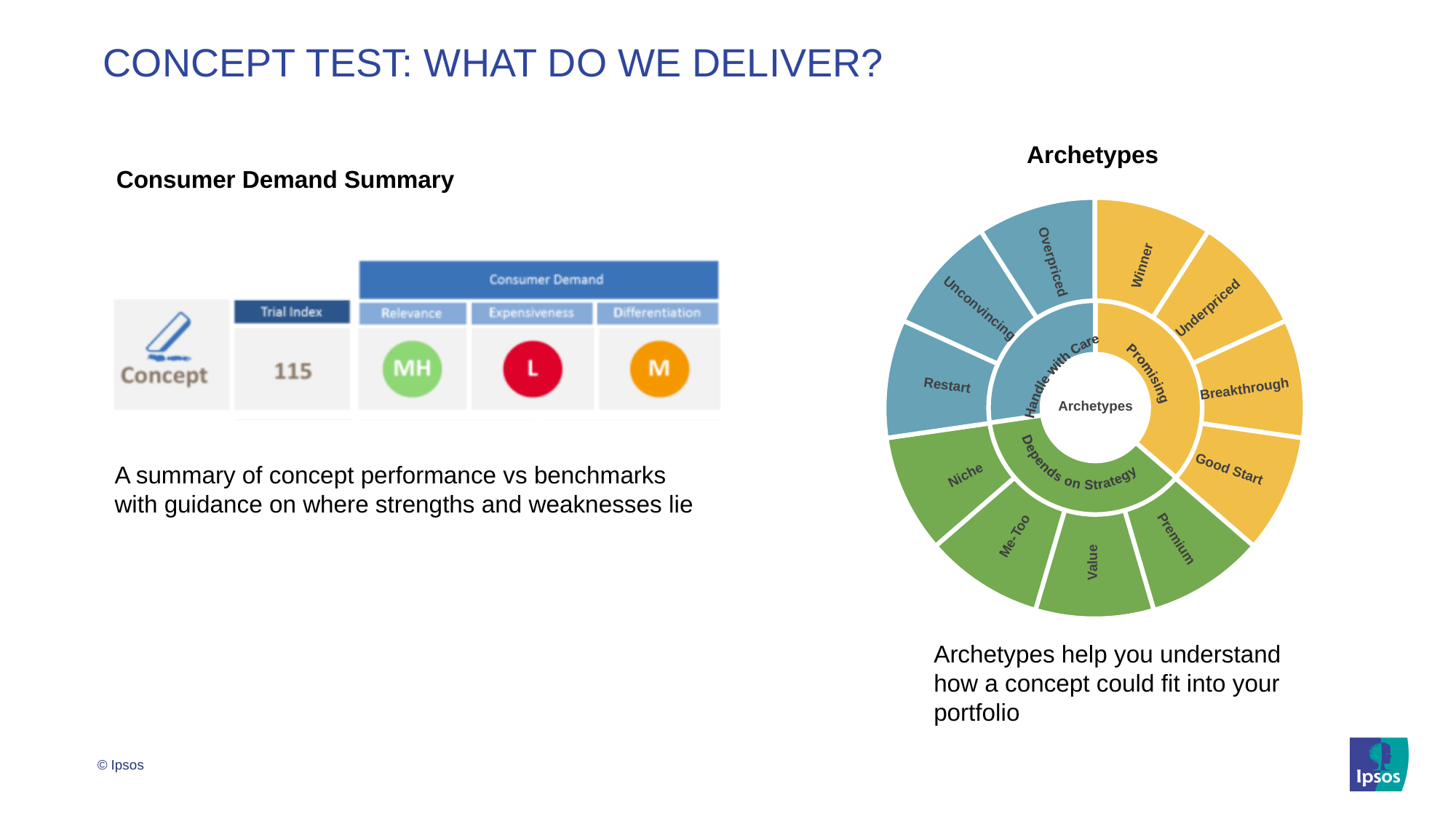
In the Archetypes chart, how many outer-ring segments belong to 'Promising'? 4 In the Archetypes chart, which inner-ring category does the 'Niche' segment belong to? Depends on Strategy What kind of chart is the Archetypes chart? doughnut chart In the Archetypes chart, which inner-ring category does the 'Premium' segment belong to? Depends on Strategy In the Archetypes chart, how many segments are in the inner ring? 3 In the Archetypes chart, what label is shown at the centre of the chart? Archetypes In the Archetypes chart, how many outer-ring segments belong to 'Handle with Care'? 3 In the Archetypes chart, which inner-ring category does the 'Restart' segment belong to? Handle with Care In the Archetypes chart, what colour are the 'Promising' segments? yellow In the Archetypes chart, which inner-ring category does the 'Winner' segment belong to? Promising